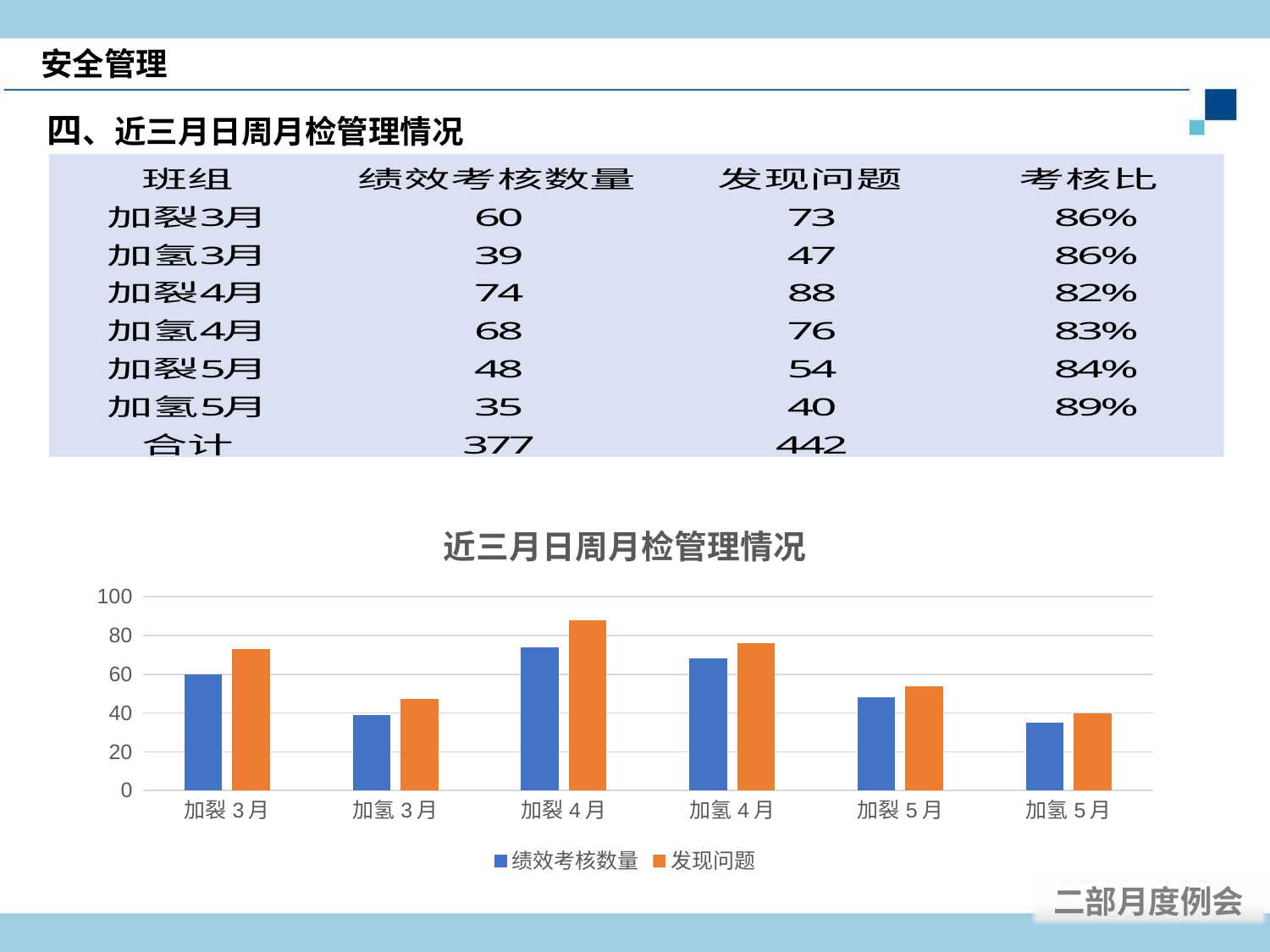
Which category has the highest 发现问题 value? 加裂4月 What is the 发现问题 value for 加氢5月? 40 Which category has the lowest 绩效考核数量 value? 加氢5月 How many series does the chart legend list? 2 What is the 绩效考核数量 value for 加裂4月? 74 What type of chart is shown on the slide? bar chart How many categories are shown on the x axis of the chart? 6 What is the difference between 发现问题 and 绩效考核数量 for 加裂3月? 13 Which is larger for 加氢4月: 绩效考核数量 or 发现问题? 发现问题 Is the 绩效考核数量 value for 加氢3月 greater or less than 40? less Is the 发现问题 value for 加裂4月 greater or less than 80? greater What is the title of the chart? 近三月日周月检管理情况